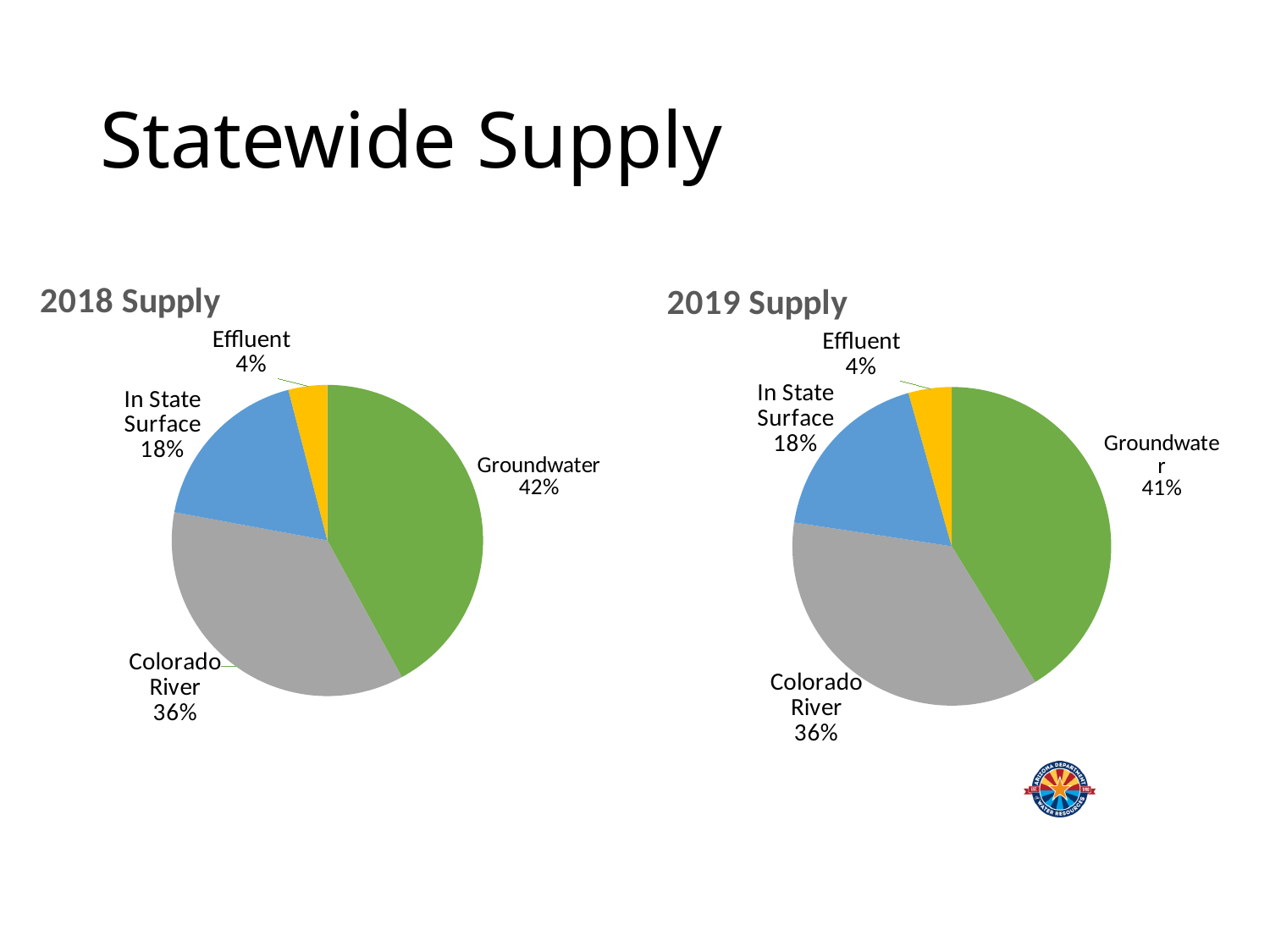
In the 2019 Supply chart, what is the difference between the In State Surface and Effluent shares? 14% In the 2018 Supply chart, what percentage is Colorado River? 36% In the 2019 Supply chart, which category has the smallest share? Effluent In the 2018 Supply chart, what share of supply is Groundwater? 42% In the 2018 Supply chart, which is larger, In State Surface or Effluent? In State Surface What type of chart is the 2018 Supply chart? Pie chart In the 2019 Supply chart, what share of supply is Groundwater? 41% In the 2019 Supply chart, what colour is the Colorado River slice? Gray In the 2019 Supply chart, what percentage is In State Surface? 18% How many categories does the 2019 Supply chart show? 4 In the 2018 Supply chart, which category has the largest share? Groundwater In the 2018 Supply chart, what is the difference between the Groundwater and Colorado River shares? 6%